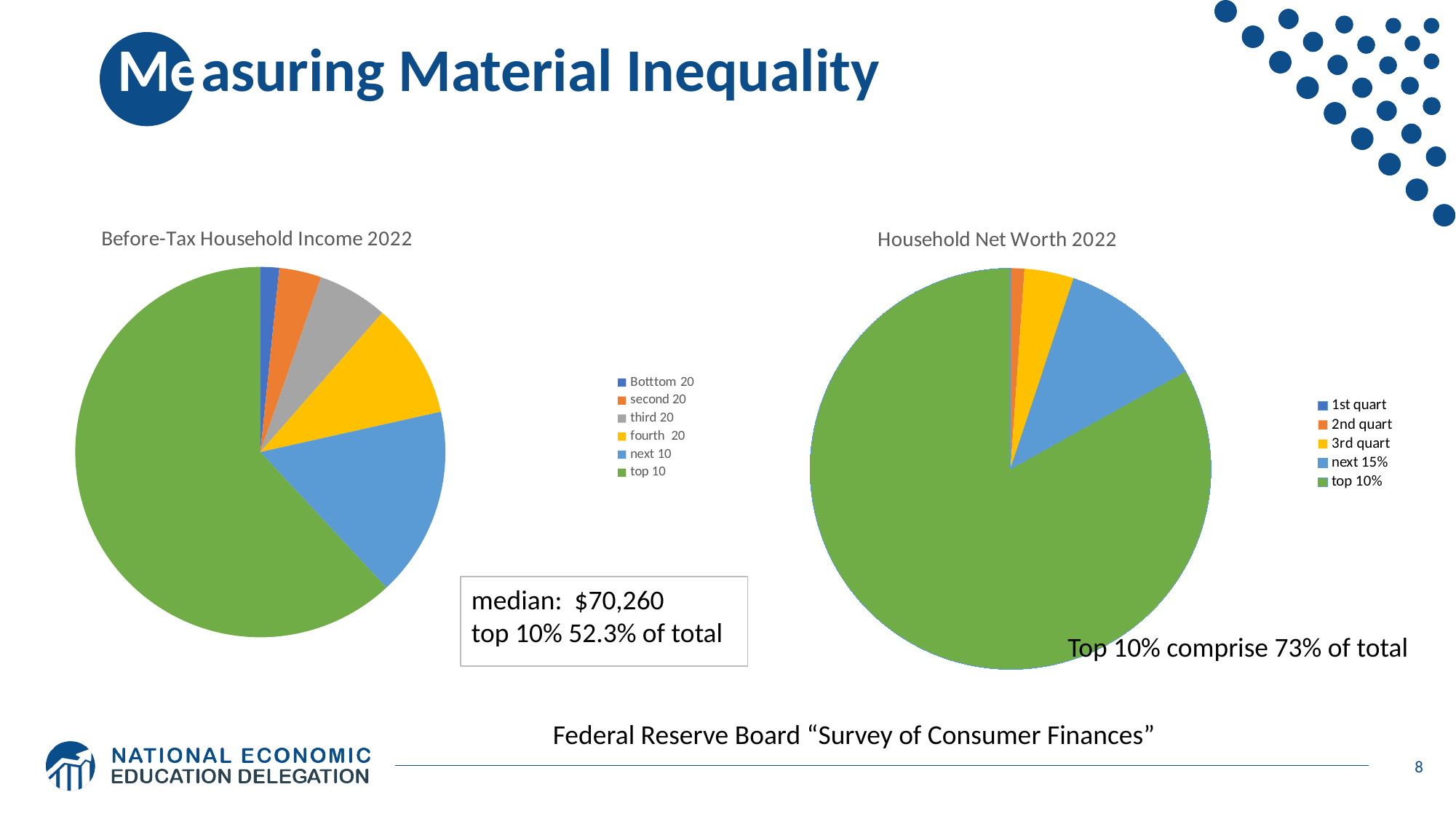
In the "Household Net Worth 2022" chart, which category has the largest slice? top 10% What type of chart is the "Before-Tax Household Income 2022" chart? pie chart What type of chart is the "Household Net Worth 2022" chart? pie chart In the "Before-Tax Household Income 2022" chart, which slice is larger: next 10 or fourth 20? next 10 According to the slide, what share of total before-tax household income does the top 10% hold in the "Before-Tax Household Income 2022" chart? 52.3% In the "Before-Tax Household Income 2022" chart, which category has the largest slice? top 10 According to the slide, what share of total household net worth does the top 10% hold in the "Household Net Worth 2022" chart? 73% In the "Before-Tax Household Income 2022" chart, which category has the smallest slice? Botttom 20 In the "Household Net Worth 2022" chart, which slice is larger: next 15% or 3rd quart? next 15% In the "Household Net Worth 2022" chart, which category has the smallest slice? 1st quart In the "Household Net Worth 2022" chart, how many categories does the legend list? 5 In the "Before-Tax Household Income 2022" chart, how many categories does the legend list? 6